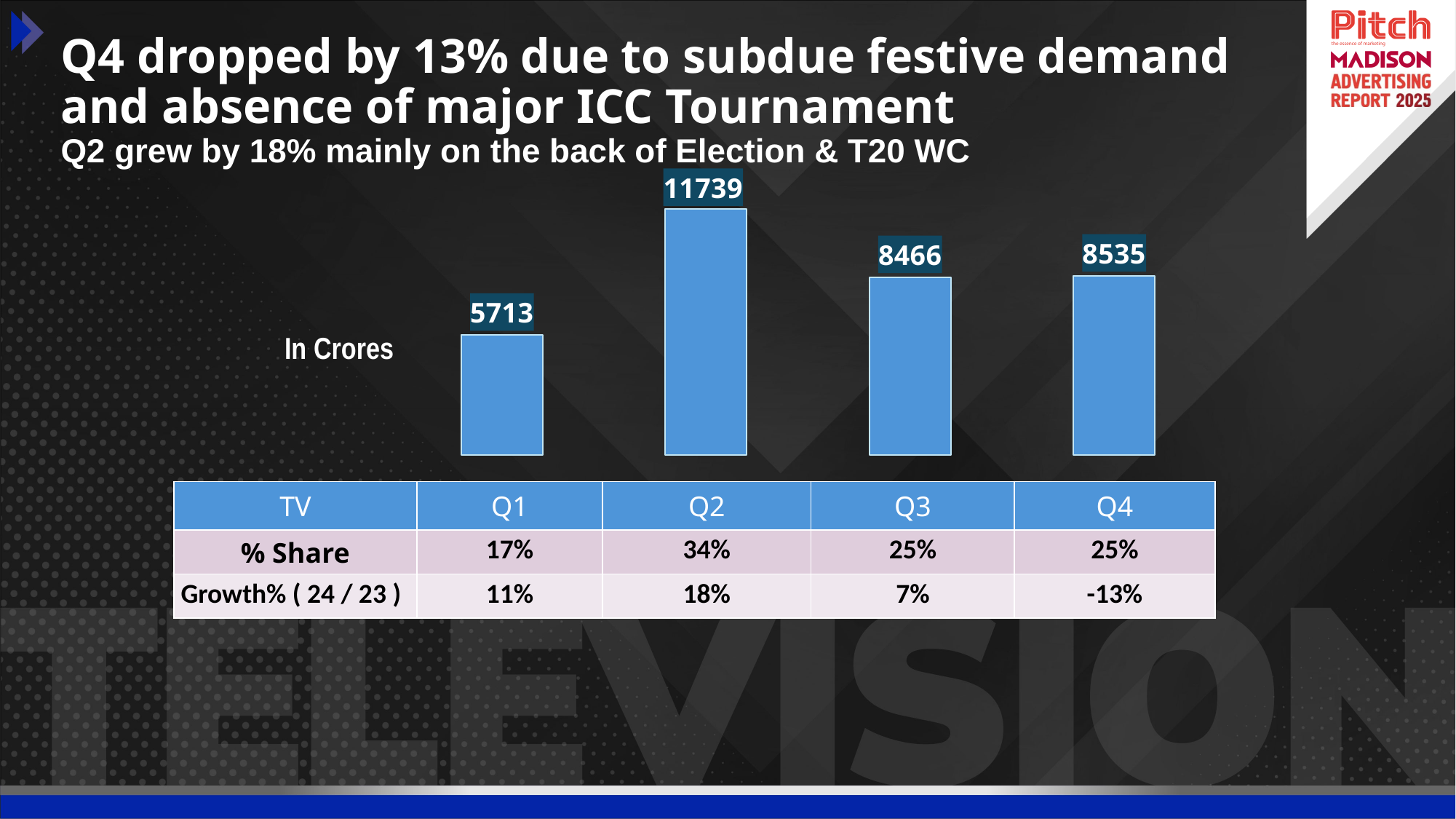
What is the value for Q4 in the bar chart? 8535 What is the difference between the Q2 and Q1 values in the bar chart? 6026 How many quarters are plotted in the bar chart? 4 Which quarter has the lowest value in the bar chart? Q1 Which is larger in the bar chart, the value for Q3 or the value for Q1? Q3 What is the value for Q1 in the bar chart? 5713 What is the difference between the Q4 and Q3 values in the bar chart? 69 Which quarter has the highest value in the bar chart? Q2 What is the total of the four quarterly values in the bar chart? 34453 What unit label is shown next to the bar chart? In Crores What kind of chart is shown on the slide? Bar chart What is the value for Q2 in the bar chart? 11739